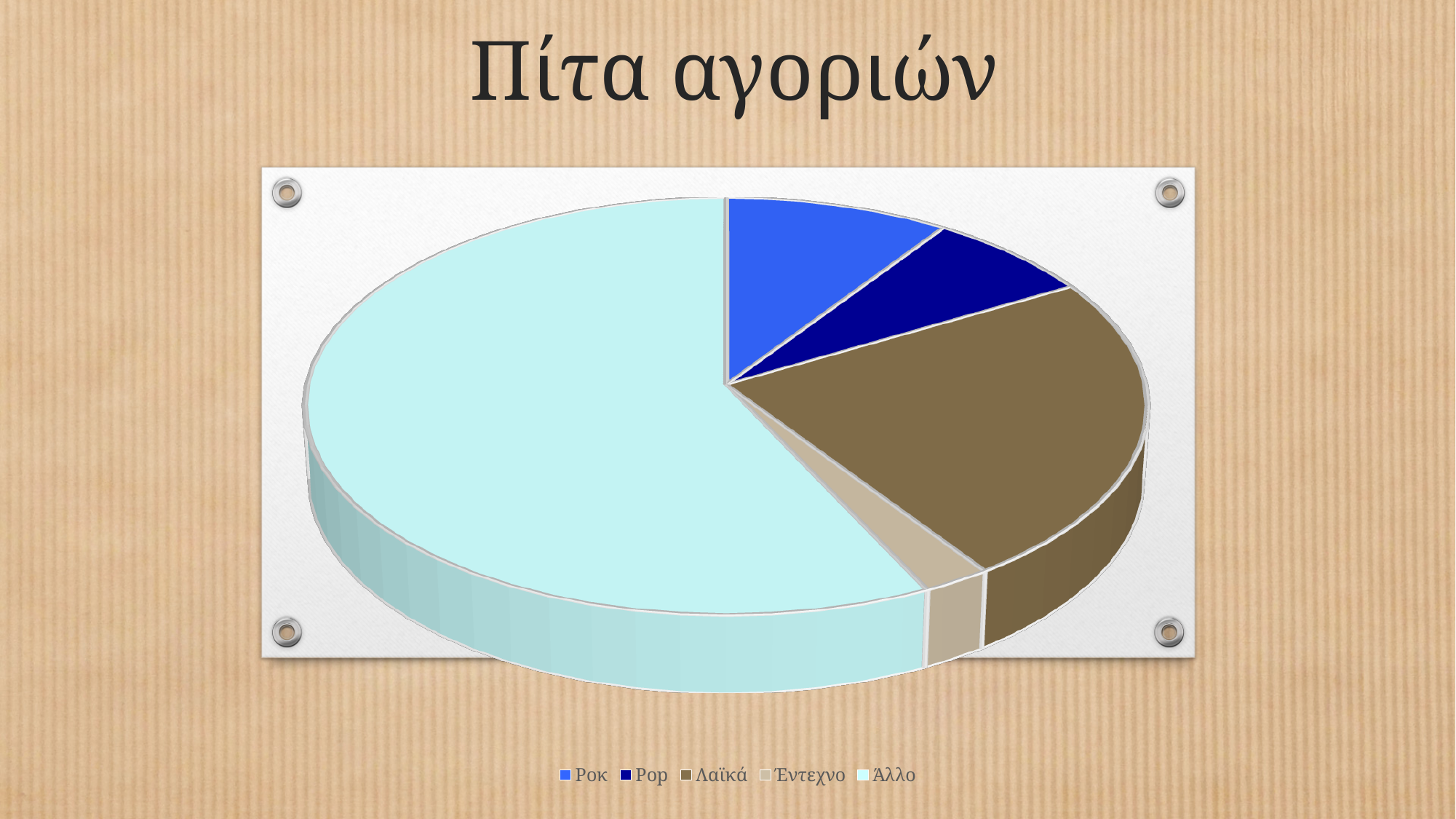
Which slice is larger, Άλλο or Λαϊκά? Άλλο Which category is listed first in the legend? Ροκ Which slice is larger, Pop or Έντεχνο? Pop Does the Άλλο slice take up more or less than half of the pie? more How many slices does the pie chart have? 5 Which category is shown in brown in the pie chart? Λαϊκά What is the title of the slide with the pie chart? Πίτα αγοριών Which slice is larger, Λαϊκά or Ροκ? Λαϊκά Which category has the largest slice of the pie? Άλλο What type of chart is shown on the slide? Pie chart Which category has the smallest slice of the pie? Έντεχνο